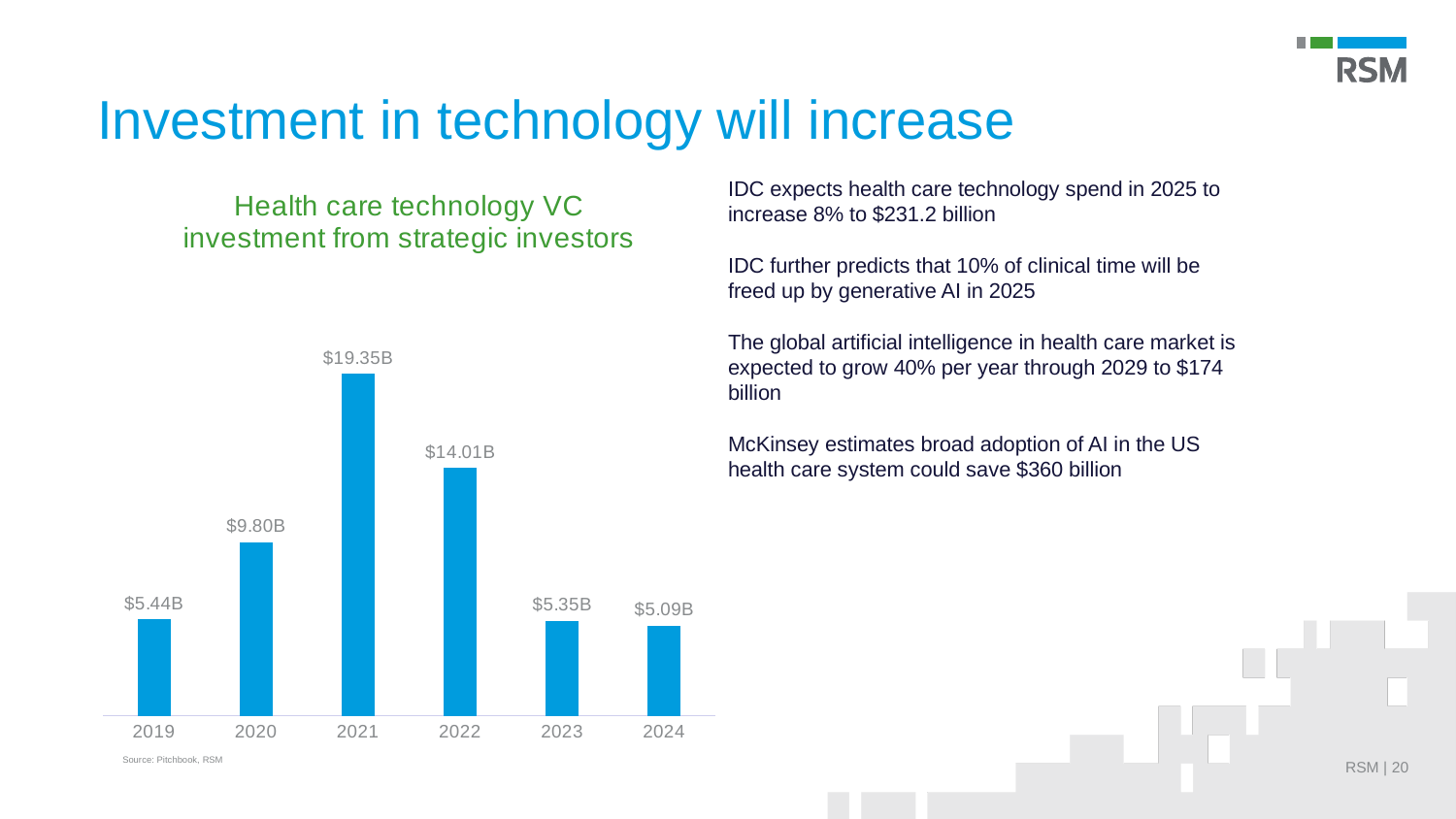
What was the health care technology VC investment from strategic investors in 2021? $19.35B What is the difference between the 2021 and 2022 values in the health care technology VC investment chart? $5.34B Which year had a larger health care technology VC investment, 2020 or 2022? 2022 What was the health care technology VC investment from strategic investors in 2024? $5.09B Which year had the highest health care technology VC investment from strategic investors? 2021 What is the difference between the 2020 and 2019 values in the health care technology VC investment chart? $4.36B How many years are shown in the health care technology VC investment chart? 6 What is the title of the chart on the slide? Health care technology VC investment from strategic investors Did health care technology VC investment from strategic investors rise or fall from 2021 to 2024? Fall Which year had the lowest health care technology VC investment from strategic investors? 2024 What was the health care technology VC investment from strategic investors in 2019? $5.44B What kind of chart is used to show health care technology VC investment from strategic investors? Bar chart